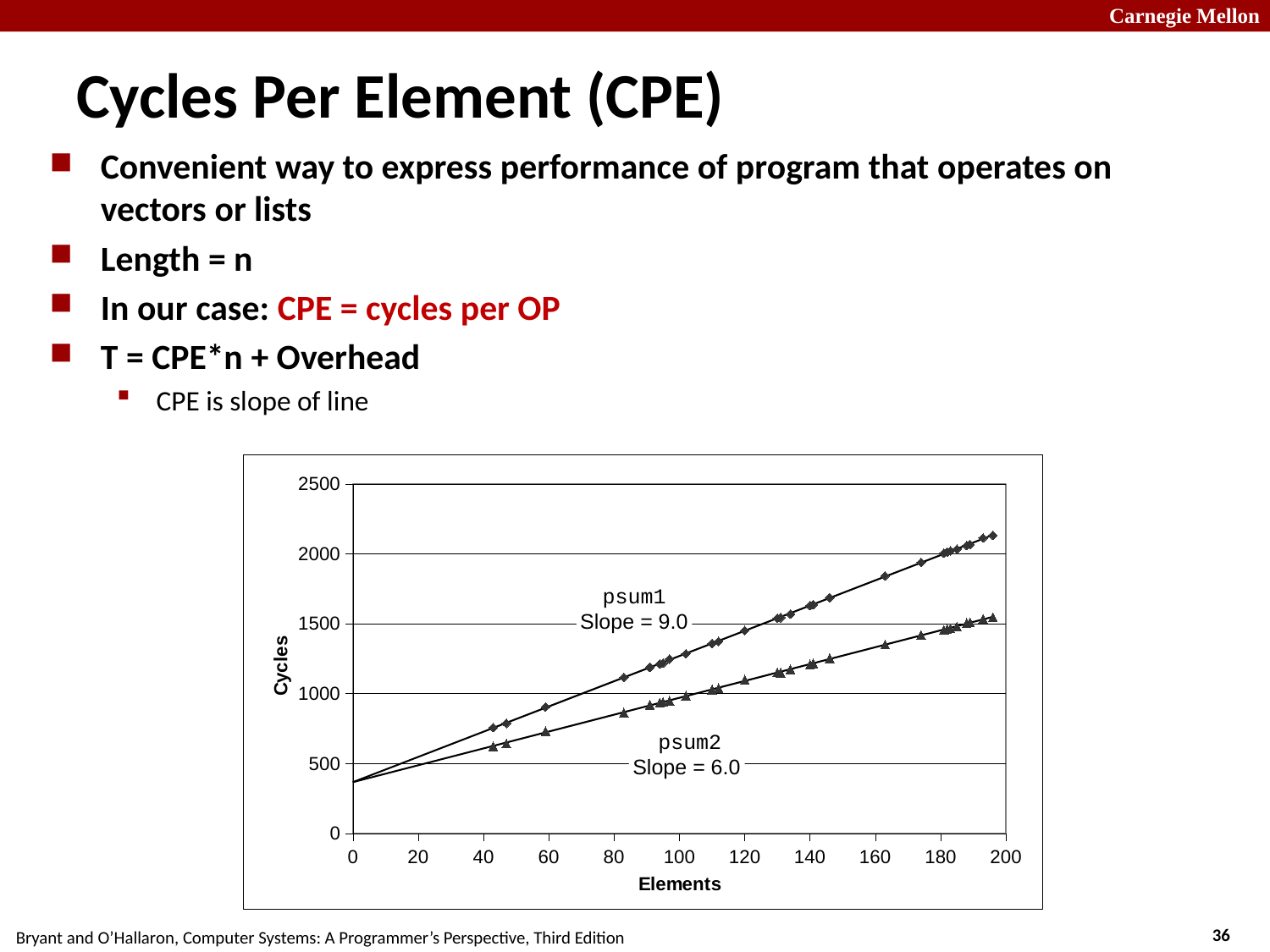
Which line has the steeper slope, psum1 or psum2? psum1 What is the slope of the psum2 line? 6.0 What is the label of the y axis? Cycles What is the difference between the slope of psum1 and the slope of psum2? 3.0 What is the label of the x axis? Elements Which series has the lower slope? psum2 Is the value for psum1 at about 195 elements greater or less than 2000 cycles? greater What is the slope of the psum1 line? 9.0 How many series are plotted on the chart? 2 What kind of chart is shown on the slide? line chart Is the value for psum2 at about 195 elements greater or less than 2000 cycles? less Do the cycle counts rise or fall as the number of elements increases? rise